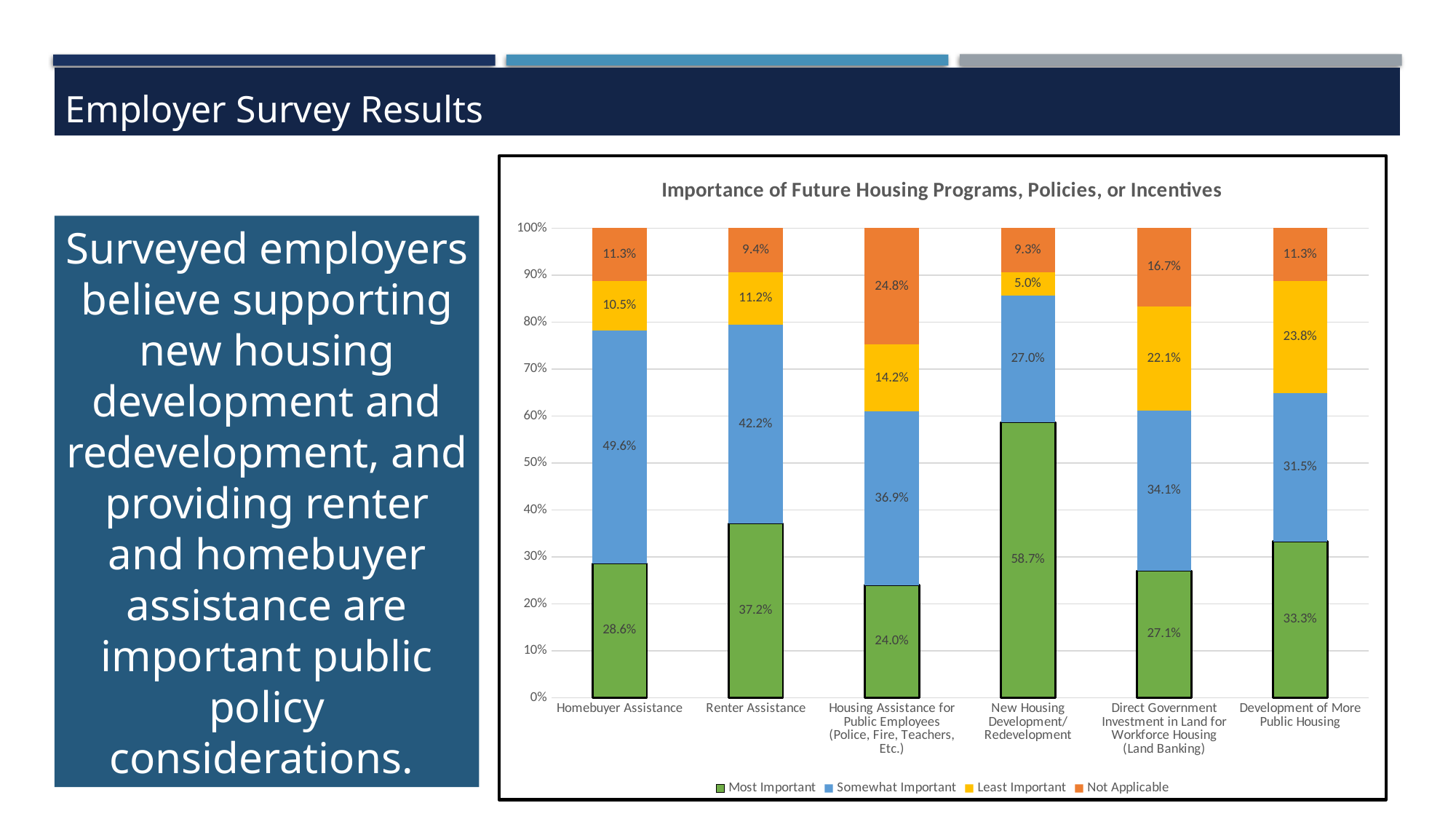
How many series does the legend list? 4 Which is larger: the Somewhat Important value for Renter Assistance or for Development of More Public Housing? Renter Assistance What is the Least Important value for Direct Government Investment in Land for Workforce Housing (Land Banking)? 22.1% What kind of chart is shown on the slide? Stacked bar chart What percentage of surveyed employers rated New Housing Development/Redevelopment as Most Important? 58.7% Which category has the lowest Least Important share? New Housing Development/Redevelopment Which category has the highest Most Important share? New Housing Development/Redevelopment What is the Not Applicable value for Housing Assistance for Public Employees (Police, Fire, Teachers, Etc.)? 24.8% What is the difference between the Most Important values for Renter Assistance and Homebuyer Assistance? 8.6% How many categories are shown on the x axis? 6 What is the Somewhat Important value for Homebuyer Assistance? 49.6% Which category has the lowest Most Important share? Housing Assistance for Public Employees (Police, Fire, Teachers, Etc.)